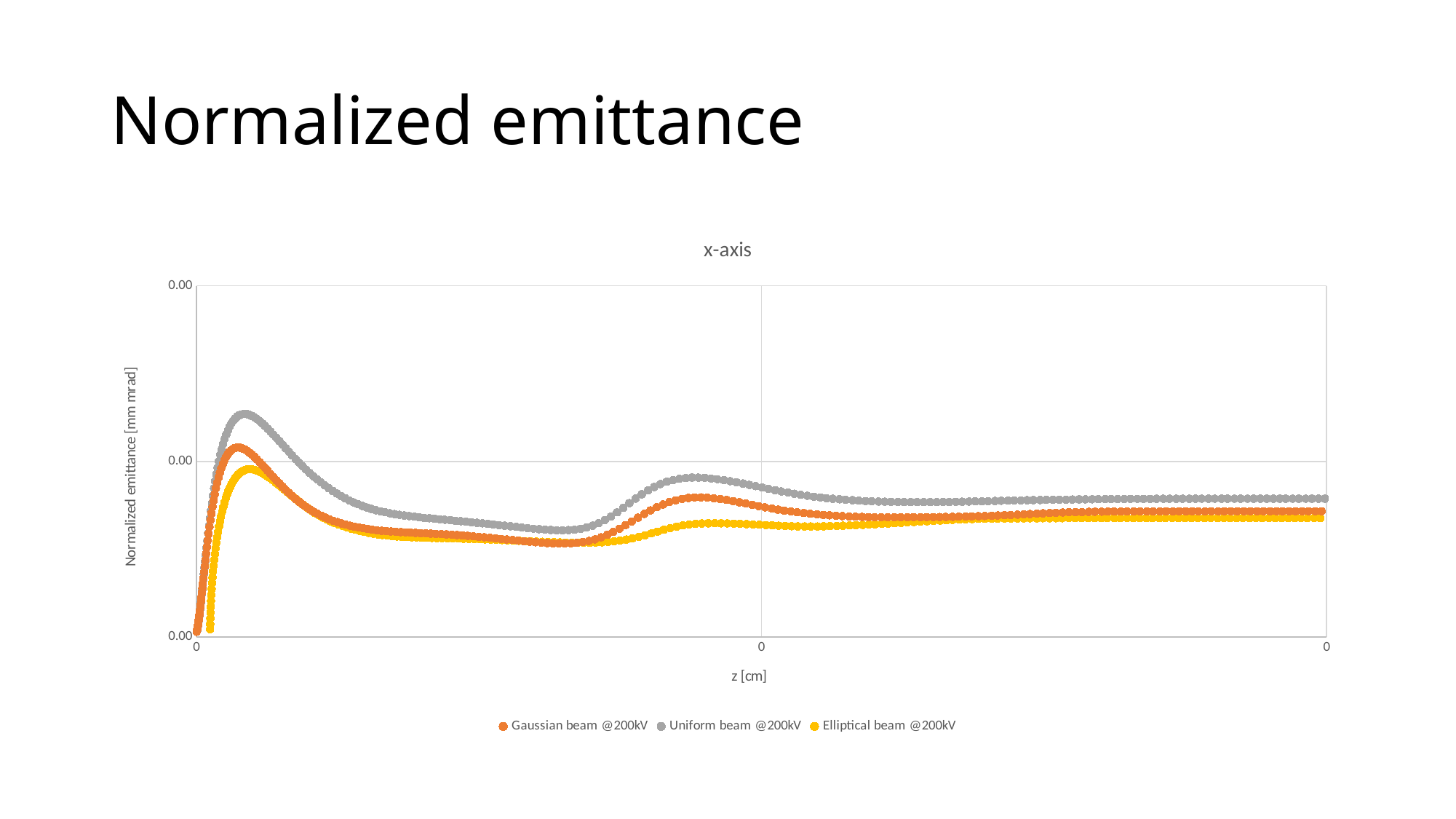
What kind of chart is shown on the slide? scatter chart Which series has the lowest initial peak near the start of the z axis? Elliptical beam @200kV At the initial peak, which series is higher: Gaussian beam @200kV or Elliptical beam @200kV? Gaussian beam @200kV Immediately after its initial peak, does the Uniform beam @200kV series rise or fall along the z axis? fall Which series lies lowest at the right end of the z axis? Elliptical beam @200kV How many series does the legend list? 3 Which series reaches the highest peak near the start of the z axis? Uniform beam @200kV At the right end of the z axis, which series is higher: Uniform beam @200kV or Elliptical beam @200kV? Uniform beam @200kV Which colour is used for the Uniform beam @200kV series? grey What is the title of the chart? x-axis